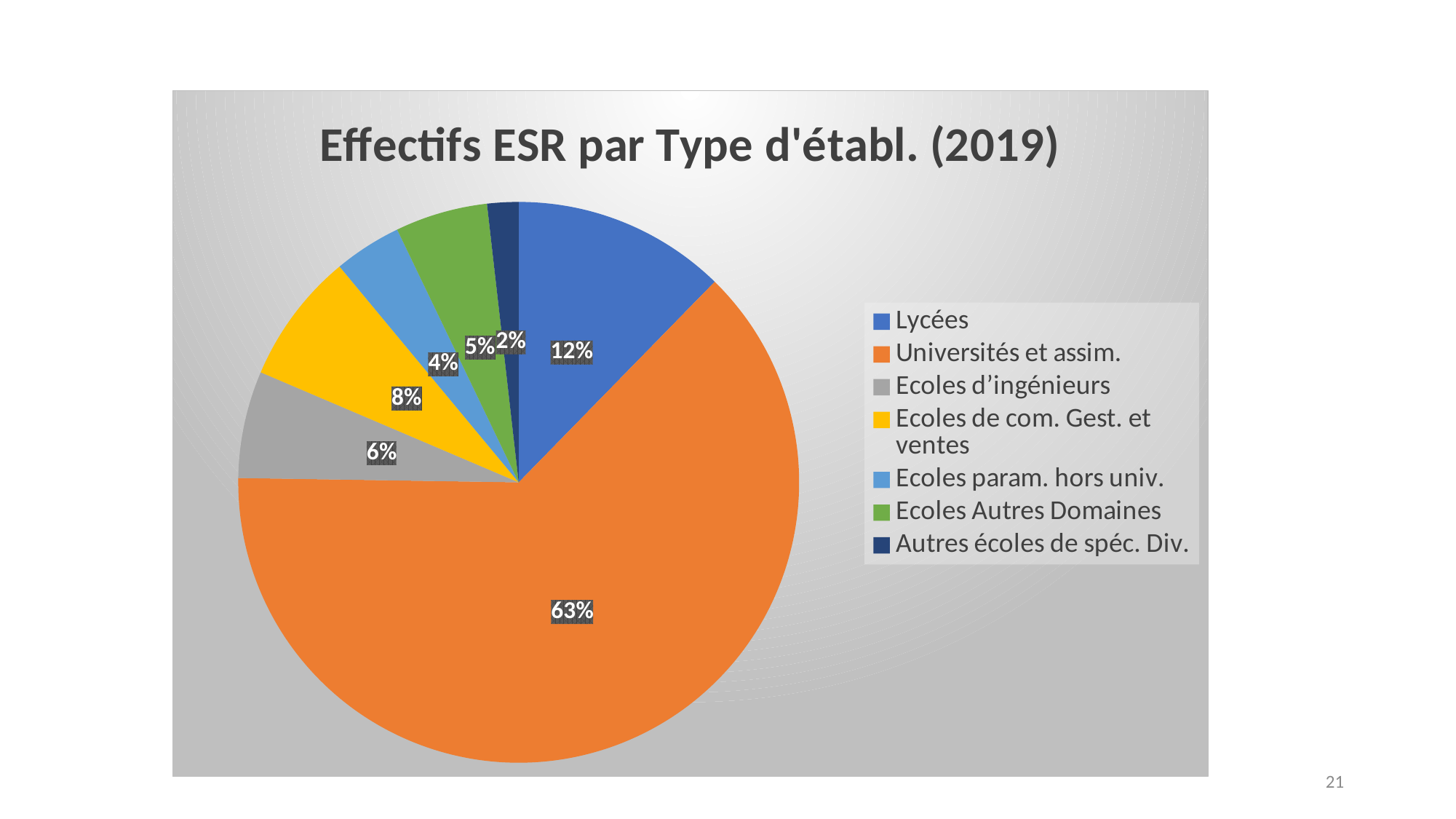
What is the value shown for Ecoles de com. Gest. et ventes? 8% What is the value shown for Ecoles param. hors univ.? 4% What type of chart is shown on the slide? Pie chart What is the value shown for Autres écoles de spéc. Div.? 2% What is the difference in percentage points between Lycées and Ecoles Autres Domaines? 7 Which category has the smallest slice of the pie? Autres écoles de spéc. Div. Which is larger, the slice for Ecoles de com. Gest. et ventes or the slice for Ecoles d’ingénieurs? Ecoles de com. Gest. et ventes How many categories does the legend list? 7 Which category has the largest slice of the pie? Universités et assim. What share of the pie does Universités et assim. hold? 63% What is the value shown for Ecoles d’ingénieurs? 6% What share of the pie does Lycées hold? 12%